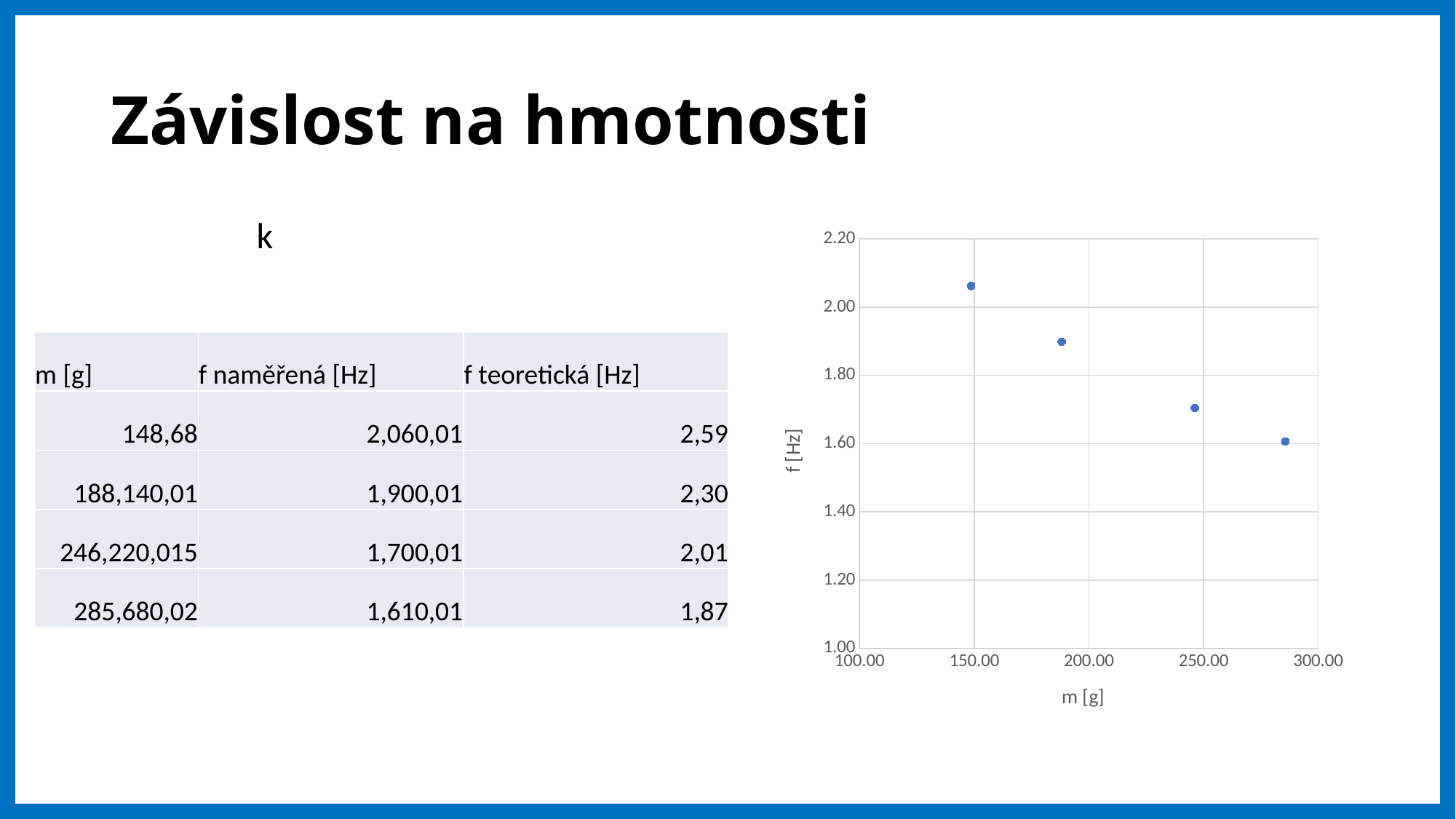
Which plotted point has the highest f value: the one near m = 150 g or the one near m = 285 g? the one near m = 150 g What is the label of the y axis of the chart? f [Hz] Do the plotted f values rise or fall as m increases along the x axis? fall Is the f value of the point near m = 190 g greater or less than 1.80? greater Is the f value of the point near m = 245 g greater or less than 1.80? less What kind of chart is shown on the slide? scatter chart Is the f value of the point near m = 150 g greater or less than 2.00? greater How many data points are plotted in the chart? 4 What is the label of the x axis of the chart? m [g]